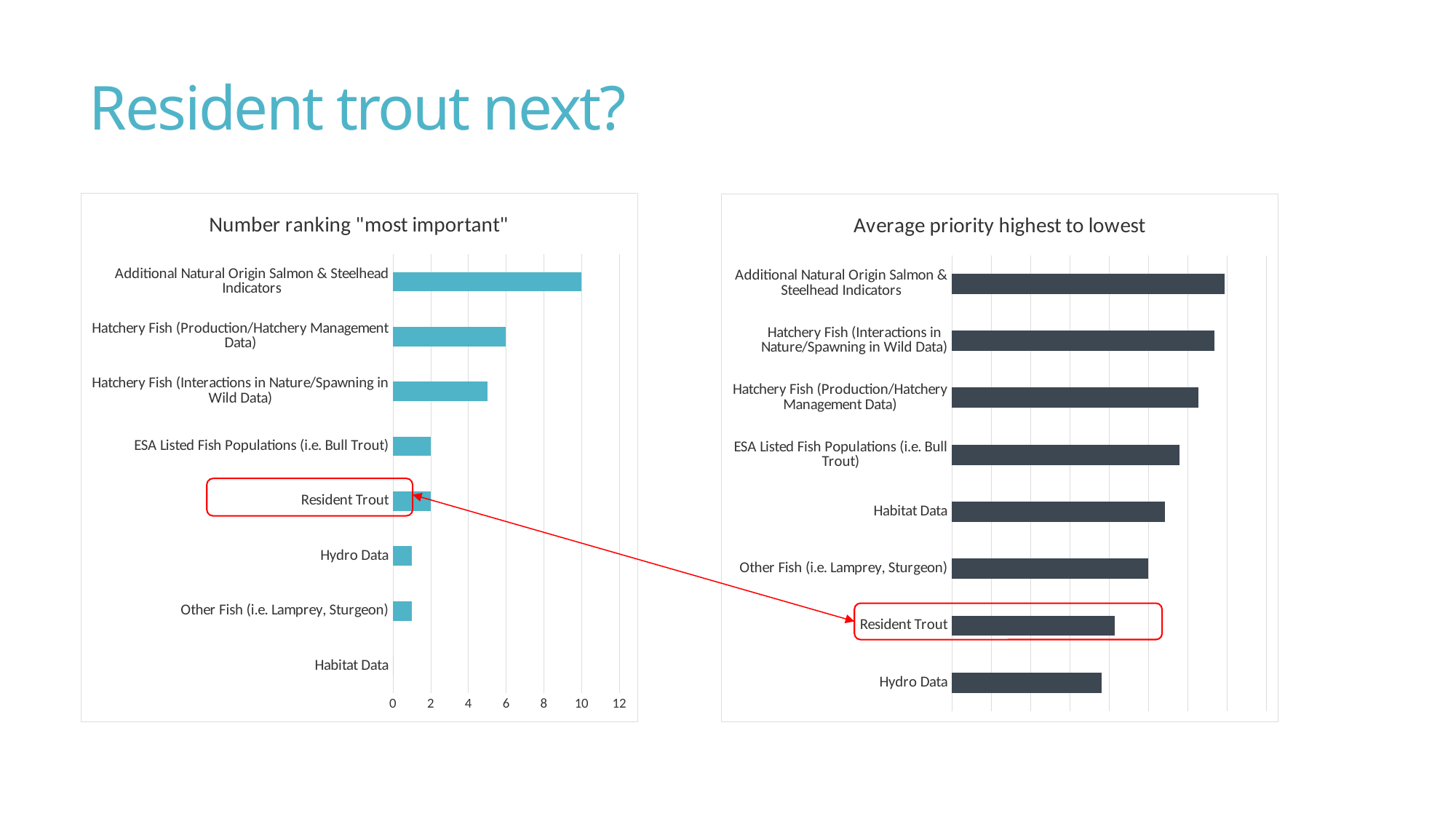
In the chart titled "Average priority highest to lowest", which category has the shortest bar? Hydro Data In the chart titled "Number ranking "most important"", what is the value for Resident Trout? 2 In the chart titled "Number ranking "most important"", what is the value for Additional Natural Origin Salmon & Steelhead Indicators? 10 In the chart titled "Number ranking "most important"", is the value for Hatchery Fish (Interactions in Nature/Spawning in Wild Data) greater or less than 4? greater In the chart titled "Number ranking "most important"", how many categories are shown? 8 In the chart titled "Number ranking "most important"", what is the value for Hatchery Fish (Production/Hatchery Management Data)? 6 What kind of chart is the chart titled "Average priority highest to lowest"? bar chart In the chart titled "Number ranking "most important"", what is the difference between Additional Natural Origin Salmon & Steelhead Indicators and Hatchery Fish (Production/Hatchery Management Data)? 4 In the chart titled "Number ranking "most important"", which category has the highest value? Additional Natural Origin Salmon & Steelhead Indicators In the chart titled "Number ranking "most important"", is the value for Hydro Data greater or less than 2? less In the chart titled "Average priority highest to lowest", which category has the longest bar? Additional Natural Origin Salmon & Steelhead Indicators In the chart titled "Average priority highest to lowest", which is larger, Habitat Data or Resident Trout? Habitat Data